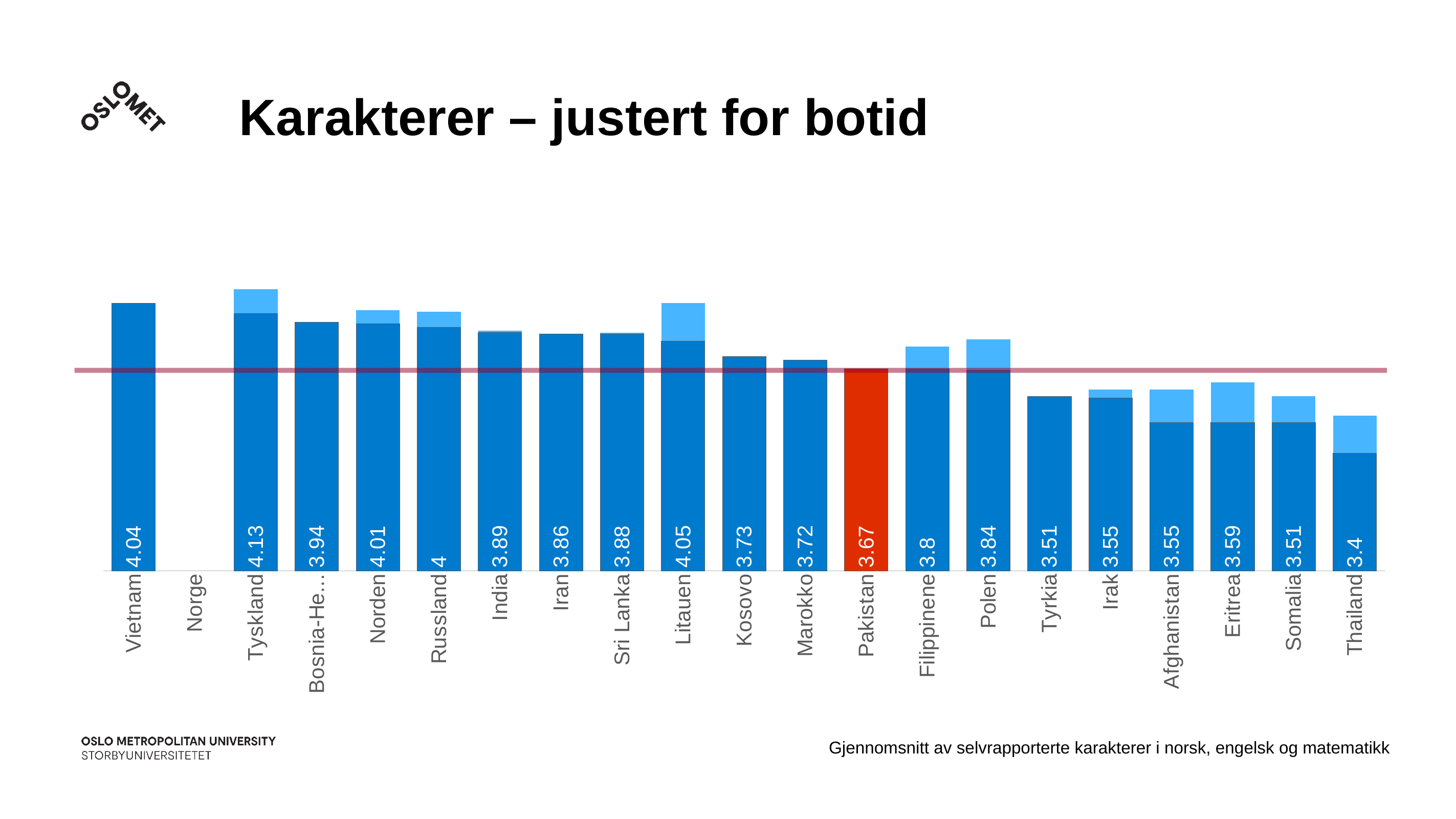
What is the difference between the values for Tyskland and Thailand? 0.73 Which country has the highest labelled value? Tyskland Which country has the lowest labelled value? Thailand Which has the larger value, Polen or Filippinene? Polen What kind of chart is shown on the slide? Bar chart What is the value shown for Tyskland? 4.13 How many country categories are listed along the x axis? 21 Which country's bar is coloured red instead of blue? Pakistan What is the value shown for Russland? 4 What is the value shown for Pakistan? 3.67 What is the difference between the values for Vietnam and Pakistan? 0.37 What is the value shown for Thailand? 3.4